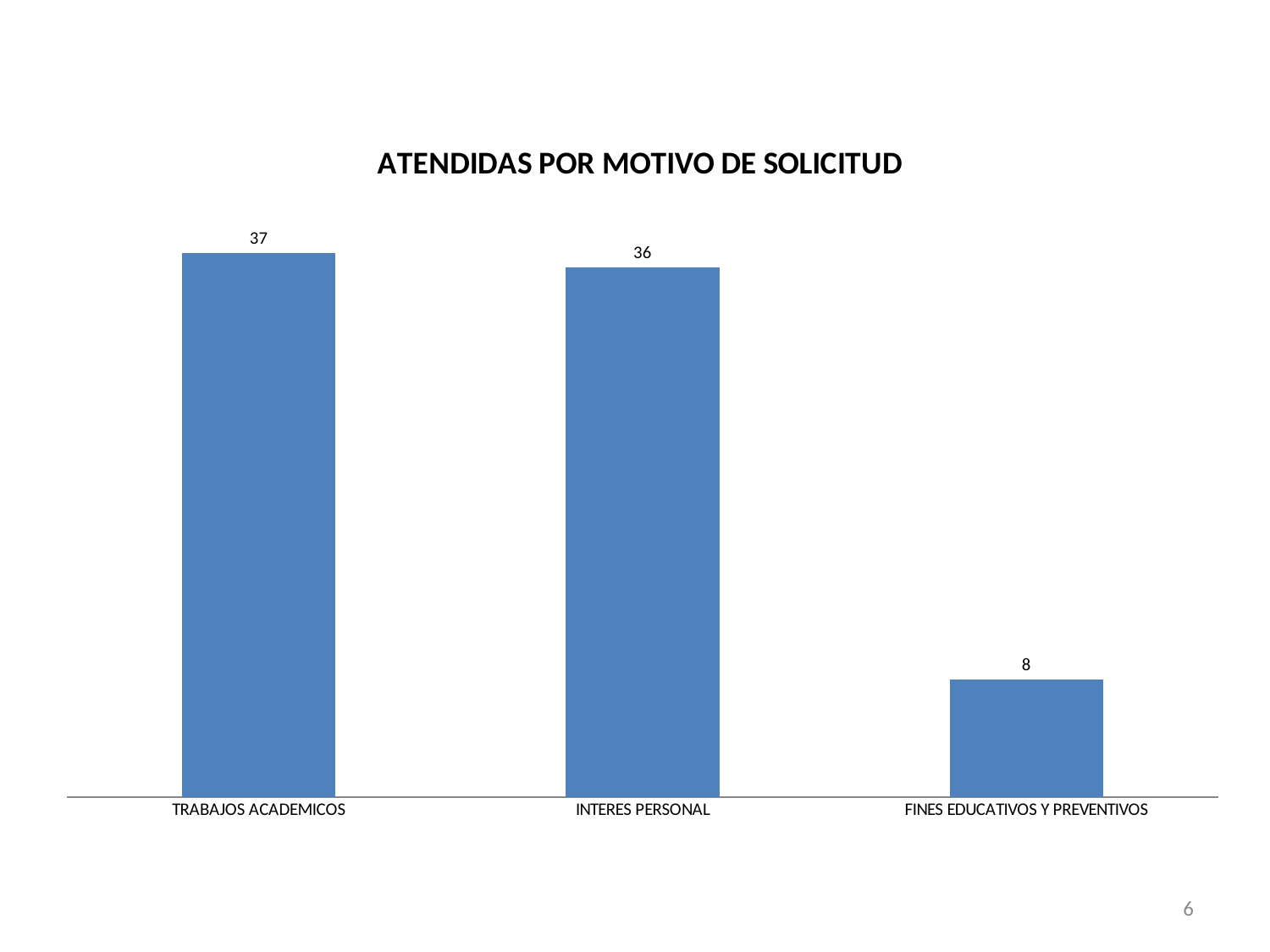
What kind of chart is shown on the slide? Bar chart What is the title of the chart? ATENDIDAS POR MOTIVO DE SOLICITUD Which is larger, the value for INTERES PERSONAL or the value for FINES EDUCATIVOS Y PREVENTIVOS? INTERES PERSONAL What colour are the bars in the chart? Blue What is the value for INTERES PERSONAL? 36 What is the difference between the values for INTERES PERSONAL and FINES EDUCATIVOS Y PREVENTIVOS? 28 Which category has the lowest value? FINES EDUCATIVOS Y PREVENTIVOS How many categories are shown in the chart? 3 Which category has the highest value? TRABAJOS ACADEMICOS What is the value for FINES EDUCATIVOS Y PREVENTIVOS? 8 What is the value for TRABAJOS ACADEMICOS? 37 What is the difference between the values for TRABAJOS ACADEMICOS and FINES EDUCATIVOS Y PREVENTIVOS? 29